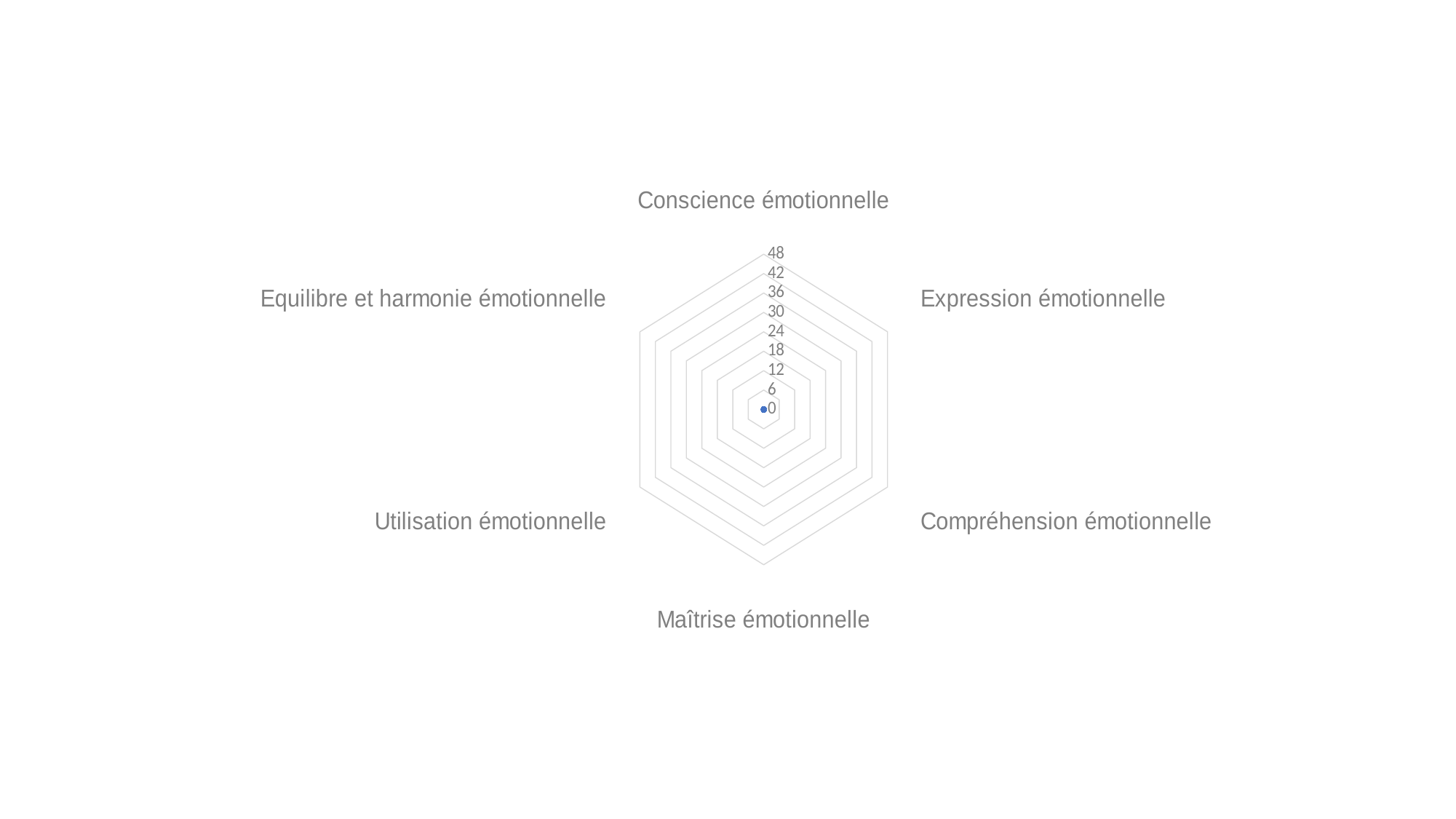
Which category label appears at the top of the radar chart? Conscience émotionnelle What value does the plotted point for Conscience émotionnelle sit on? 0 Is the value for Conscience émotionnelle greater or less than 24? less Is the value for Compréhension émotionnelle greater or less than 18? less Is the value for Expression émotionnelle greater or less than 12? less What is the highest value shown on the radar chart's axis scale? 48 What kind of chart is shown on the slide? Radar chart How many categories (axes) does the radar chart have? 6